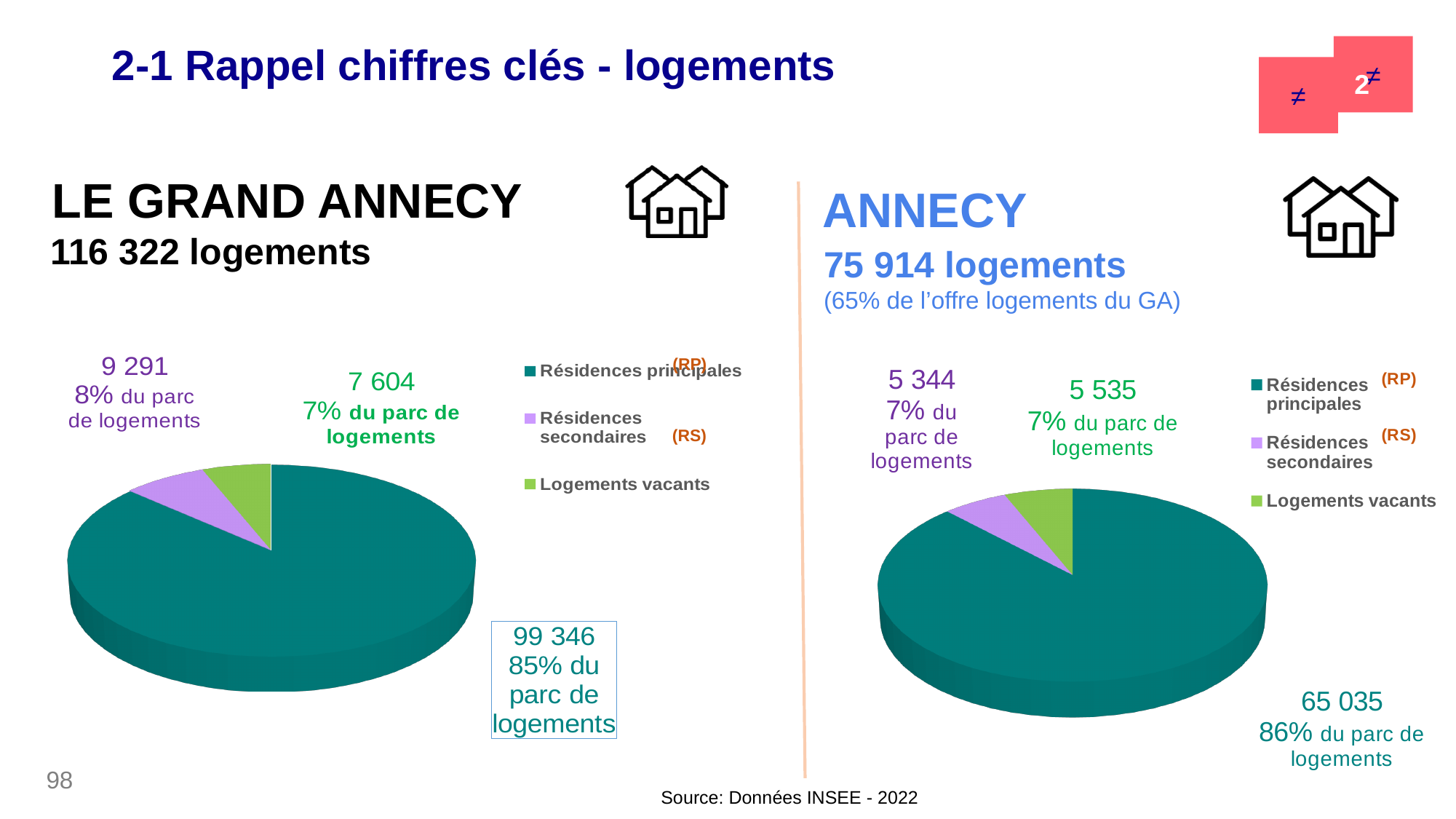
On the Le Grand Annecy pie chart, how many logements are Résidences principales? 99 346 On the Le Grand Annecy pie chart, which category is the largest? Résidences principales On the Annecy pie chart, what share of the parc de logements do Résidences principales represent? 86% On the Le Grand Annecy pie chart, what is the difference between Résidences secondaires and Logements vacants? 1 687 On the Le Grand Annecy pie chart, which is larger: Résidences secondaires or Logements vacants? Résidences secondaires On the Annecy pie chart, how many logements are Résidences principales? 65 035 On the Le Grand Annecy pie chart, how many Logements vacants are there? 7 604 On the Le Grand Annecy pie chart, what share of the parc de logements do Résidences secondaires represent? 8% What type of chart is used for Le Grand Annecy? Pie chart How many categories does the Annecy pie chart show? 3 On the Annecy pie chart, which category is the smallest? Résidences secondaires On the Annecy pie chart, what is the difference between Logements vacants and Résidences secondaires? 191